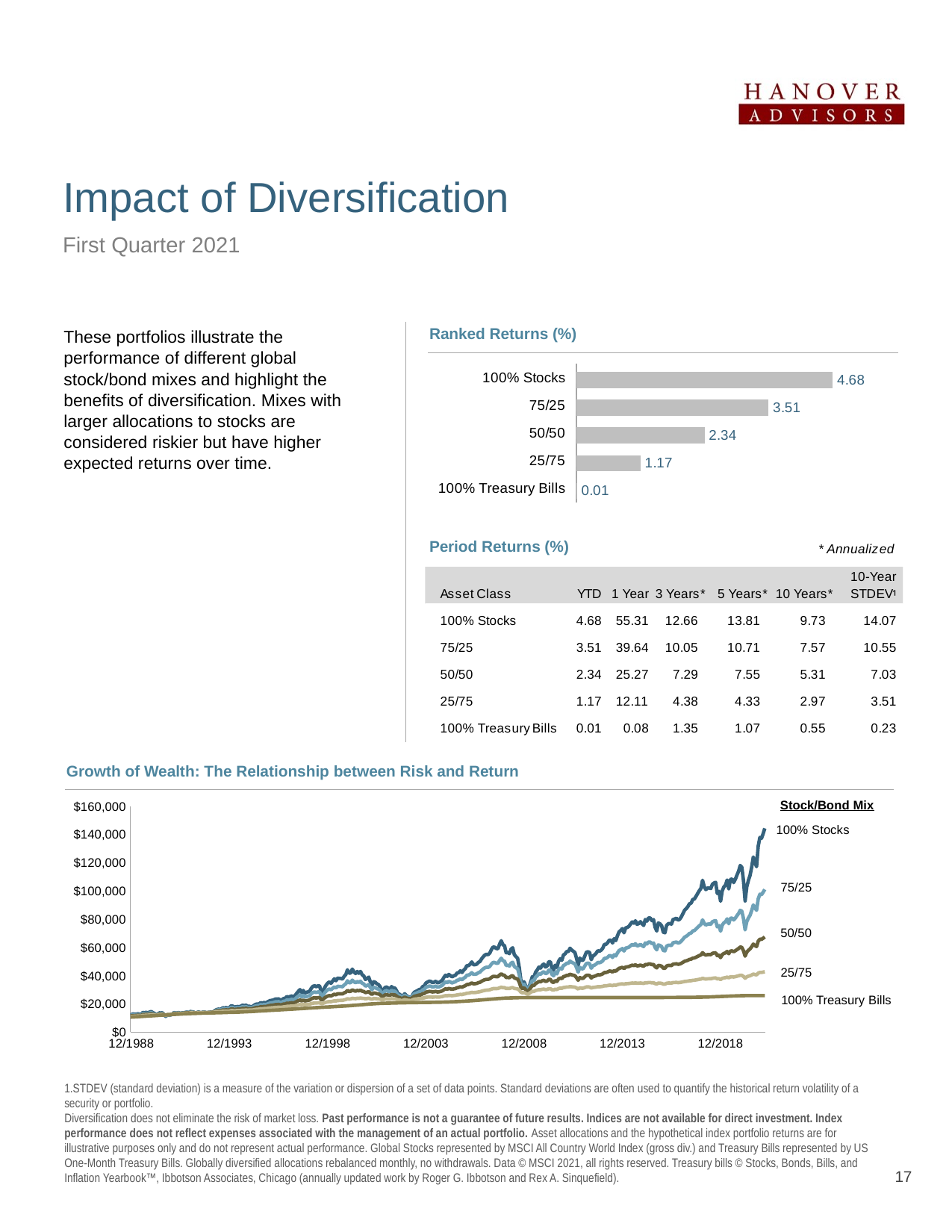
What kind of chart is the Growth of Wealth: The Relationship between Risk and Return chart? Line chart In the Ranked Returns (%) chart, which category has the highest value? 100% Stocks How many categories are shown in the Ranked Returns (%) chart? 5 In the Ranked Returns (%) chart, which is larger, the value for 50/50 or the value for 25/75? 50/50 In the Ranked Returns (%) chart, which category has the lowest value? 100% Treasury Bills In the Ranked Returns (%) chart, what is the value for 100% Treasury Bills? 0.01 What kind of chart is the Ranked Returns (%) chart? Bar chart In the Ranked Returns (%) chart, what is the value for 50/50? 2.34 How many stock/bond mixes are plotted in the Growth of Wealth chart? 5 In the Ranked Returns (%) chart, what is the difference between the values for 75/25 and 25/75? 2.34 In the Ranked Returns (%) chart, what is the value for 100% Stocks? 4.68 In the Growth of Wealth chart, is the final value of the 100% Treasury Bills line greater or less than $40,000? less